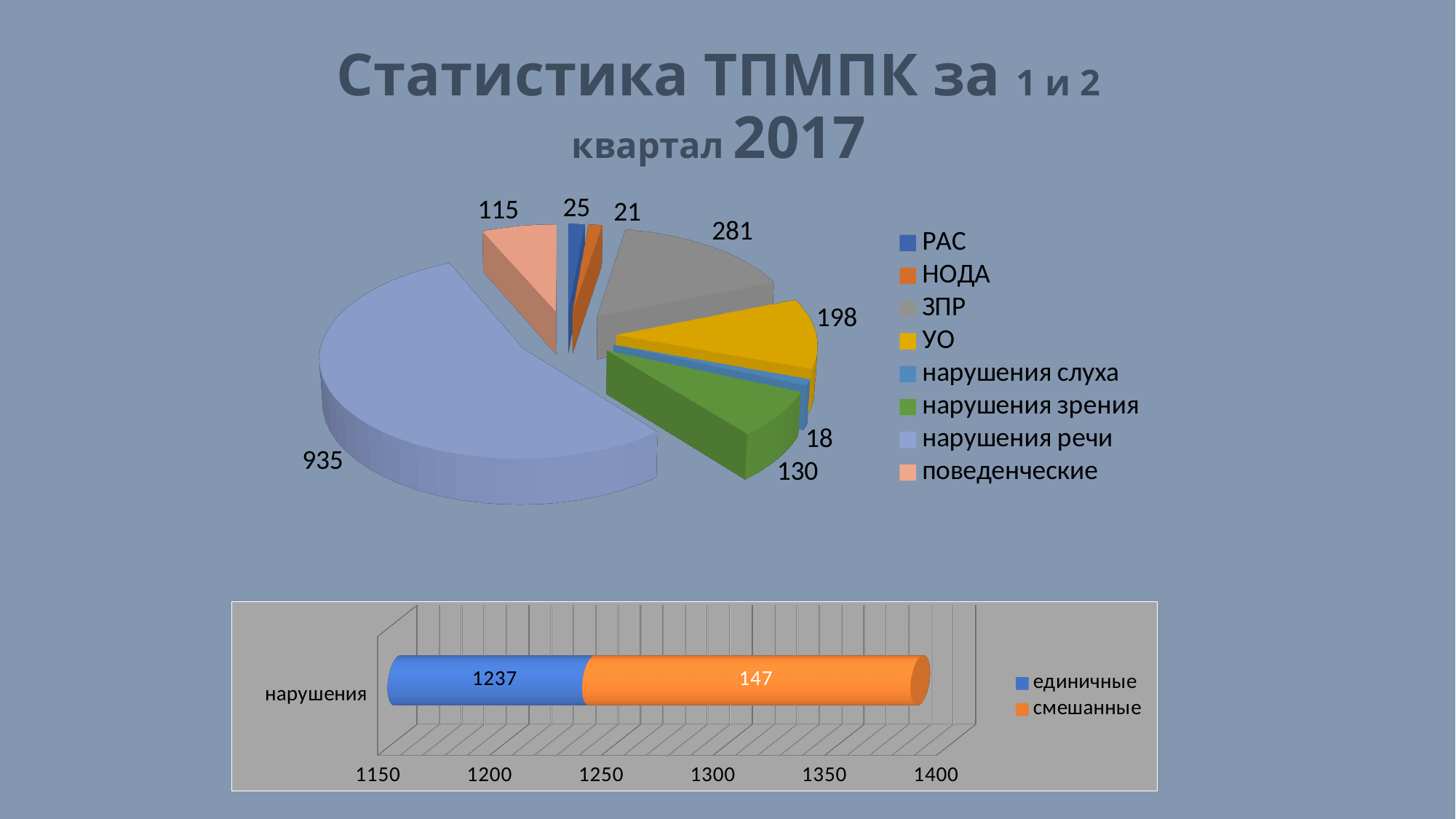
What kind of chart is shown at the top of the slide? Pie chart How many categories does the legend of the pie chart at the top of the slide list? 8 In the pie chart at the top of the slide, which category has the largest value? нарушения речи In the pie chart at the top of the slide, what is the value for нарушения речи? 935 In the pie chart at the top of the slide, which category has the smallest value? нарушения слуха In the bar chart at the bottom of the slide, what is the total of the stacked bar for нарушения? 1384 In the pie chart at the top of the slide, what is the value for ЗПР? 281 In the pie chart at the top of the slide, what is the value for поведенческие? 115 How many series does the legend of the bar chart at the bottom of the slide list? 2 In the pie chart at the top of the slide, which is larger, the value for РАС or the value for НОДА? РАС In the bar chart at the bottom of the slide, what is the value for единичные? 1237 In the pie chart at the top of the slide, what is the difference between the values for ЗПР and УО? 83